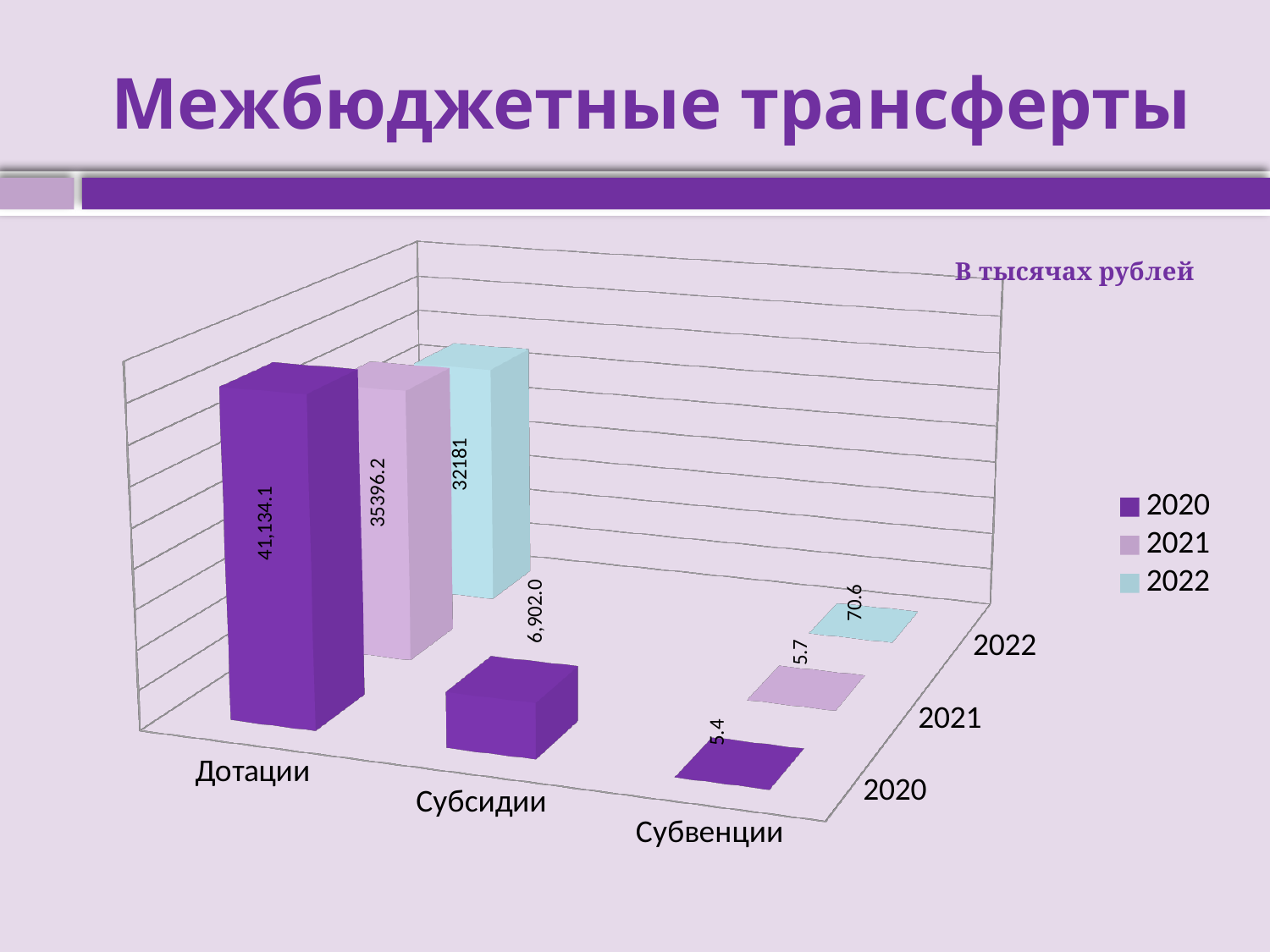
What is the value for Дотации in 2020? 41,134.1 What is the difference between the Дотации values for 2020 and 2021? 5737.9 What is the value for Дотации in 2021? 35396.2 Which category has the highest value in 2020? Дотации What is the value for Дотации in 2022? 32181 What is the value for Субсидии in 2020? 6,902.0 How many series does the legend list? 3 Which is larger for Субвенции: the 2022 value or the 2020 value? 2022 What is the difference between the Субвенции values for 2022 and 2021? 64.9 Which category has the lowest value in 2020? Субвенции What is the value for Субвенции in 2022? 70.6 Do the Дотации values rise or fall from 2020 to 2022? fall